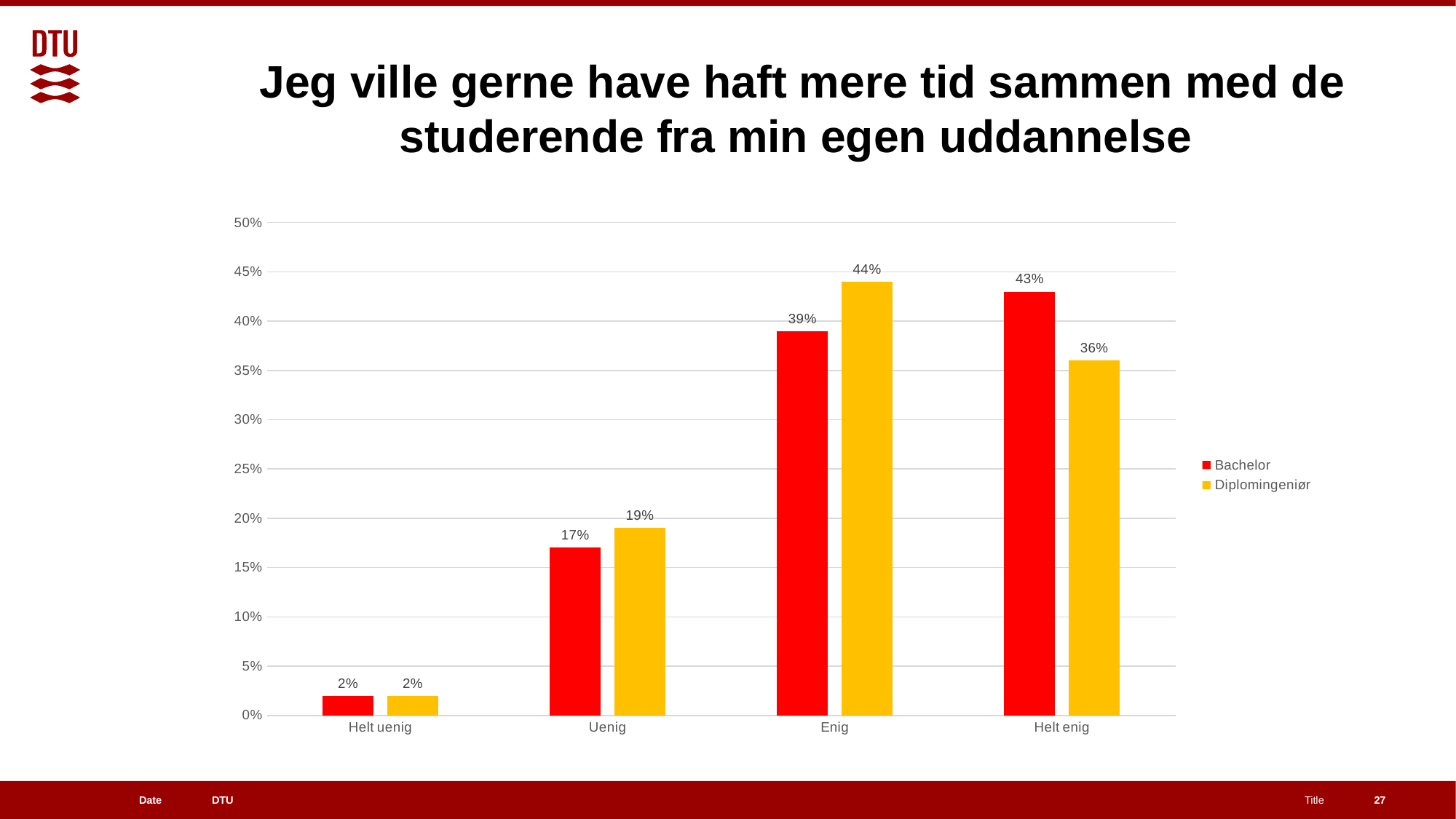
What is the value for Diplomingeniør in the Uenig category? 19% What is the value for Bachelor in the Enig category? 39% What kind of chart is shown on the slide? Bar chart Which category has the lowest value for the Diplomingeniør series? Helt uenig How many categories are shown on the x axis? 4 Which category has the highest value for the Bachelor series? Helt enig What is the value for Diplomingeniør in the Helt enig category? 36% What is the difference between the Bachelor and Diplomingeniør values in the Helt enig category? 7% Is the value for Bachelor in the Helt enig category greater or less than 40%? greater In the Uenig category, which series has the larger value, Bachelor or Diplomingeniør? Diplomingeniør How many series does the legend list? 2 What is the difference between the Diplomingeniør and Bachelor values in the Enig category? 5%